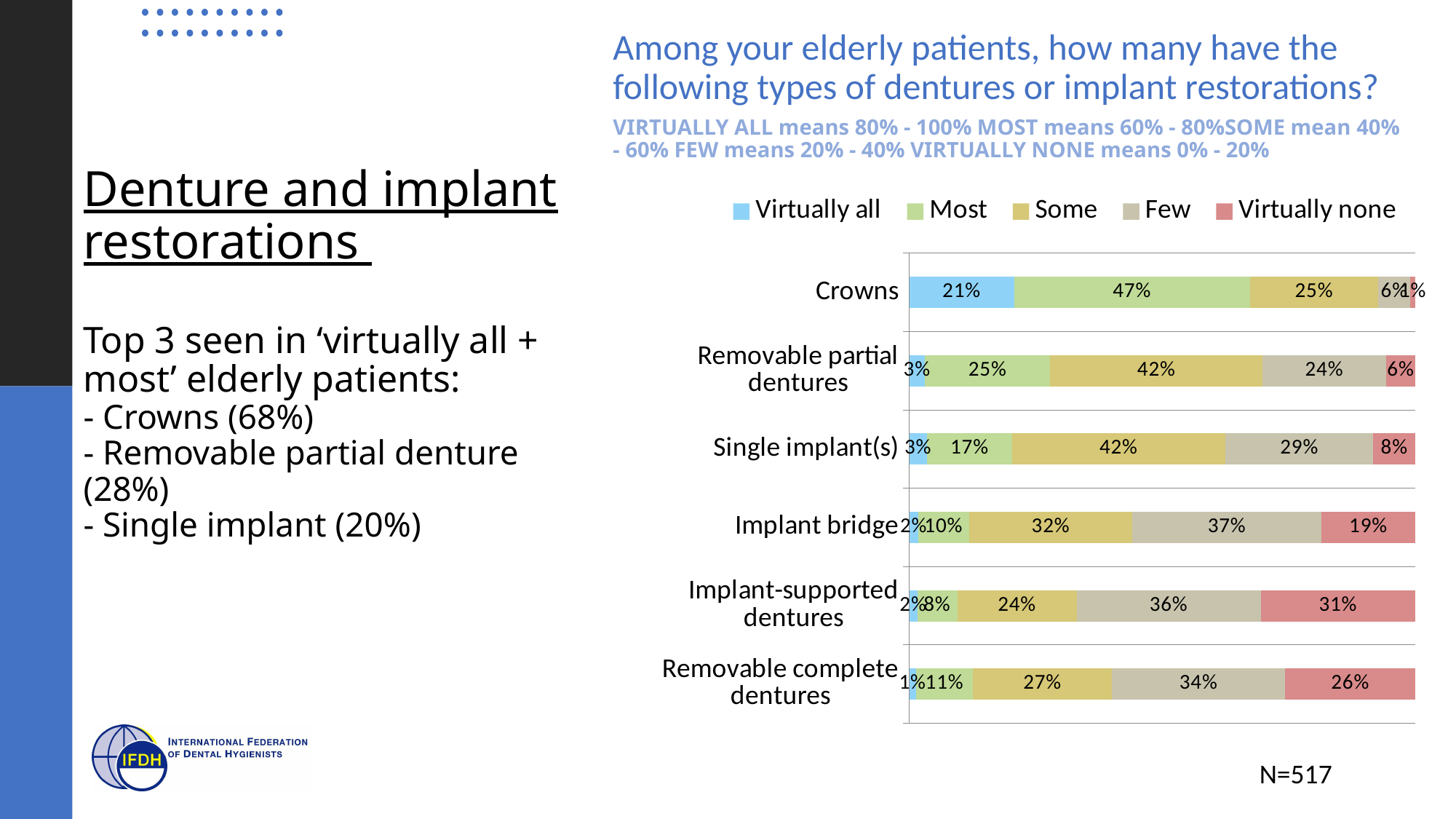
For Removable partial dentures, what is the difference between the 'Some' value and the 'Few' value? 18 percentage points Which restoration type has the highest 'Virtually none' value? Implant-supported dentures What percentage of respondents said 'Most' of their elderly patients have Crowns? 47% How many restoration types (categories) are plotted in the chart? 6 How many series does the chart legend list? 5 What is the 'Virtually none' value for Implant bridge? 19% What kind of chart is shown on the slide? Stacked bar chart Which restoration type has the highest 'Virtually all' value? Crowns For Implant bridge, which is larger: the 'Some' value or the 'Few' value? Few What sample size (N) is shown for the chart? N=517 What is the 'Virtually none' value for Implant-supported dentures? 31% What is the 'Few' value for Single implant(s)? 29%